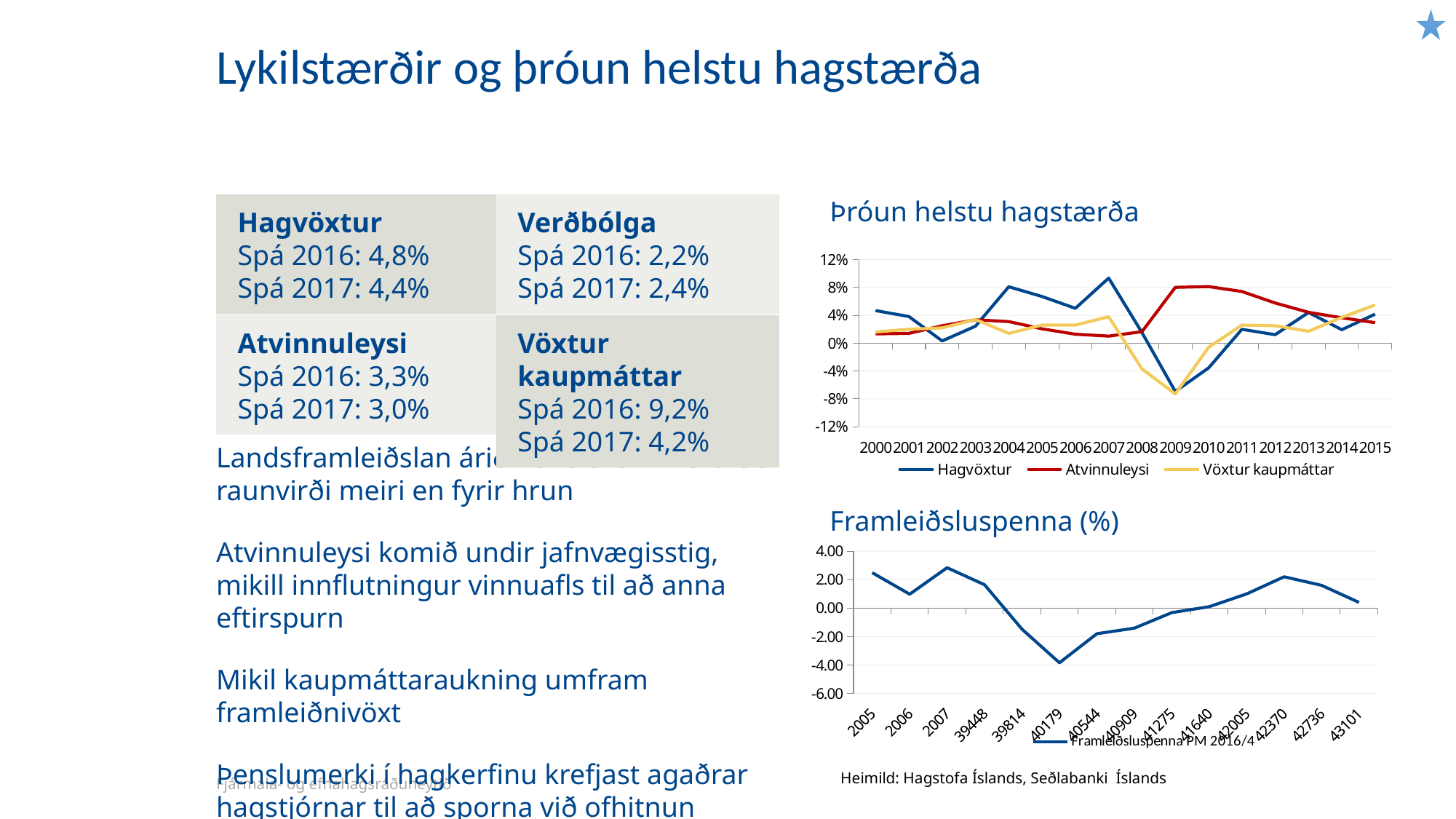
In the 'Þróun helstu hagstærða' chart, is the Hagvöxtur value for 2007 greater or less than 8%? greater In the 'Framleiðsluspenna (%)' chart, does the value rise or fall from 2007 to 40179? fall In the 'Þróun helstu hagstærða' chart, is the Atvinnuleysi value for 2009 greater or less than 4%? greater What type of chart is the 'Framleiðsluspenna (%)' chart? line chart In the 'Þróun helstu hagstærða' chart, which is larger in 2009: Hagvöxtur or Atvinnuleysi? Atvinnuleysi In the 'Þróun helstu hagstærða' chart, in which year is Hagvöxtur lowest? 2009 In the 'Þróun helstu hagstærða' chart, which colour is the Atvinnuleysi line? red What type of chart is the 'Þróun helstu hagstærða' chart? line chart In the 'Þróun helstu hagstærða' chart, in which year is Hagvöxtur highest? 2007 How many years are shown on the x axis of the 'Þróun helstu hagstærða' chart? 16 In the 'Framleiðsluspenna (%)' chart, at which x-axis label is the value lowest? 40179 How many series does the legend of the 'Þróun helstu hagstærða' chart list? 3